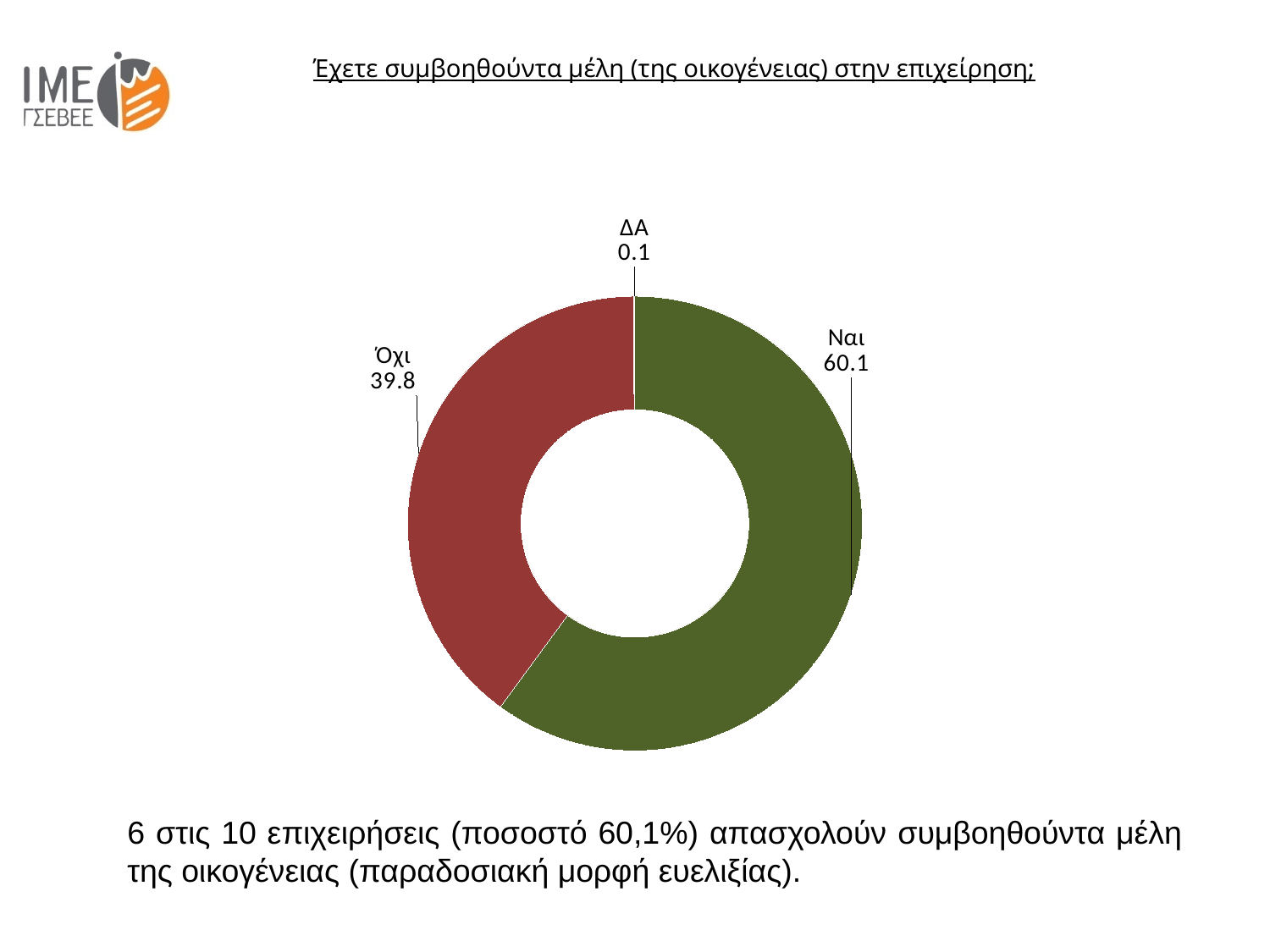
What value is shown for the "ΔΑ" slice? 0.1 What kind of chart is shown on the slide? Doughnut (pie) chart What value is shown for the "Ναι" slice? 60.1 Which is larger, the value for "Ναι" or the value for "Όχι"? Ναι Which category has the smallest slice? ΔΑ How many categories are shown in the chart? 3 What value is shown for the "Όχι" slice? 39.8 What is the title of the chart on the slide? Έχετε συμβοηθούντα μέλη (της οικογένειας) στην επιχείρηση; Which category has the largest slice? Ναι What colour is the "Όχι" slice? Red What is the difference between the values for "Ναι" and "Όχι"? 20.3